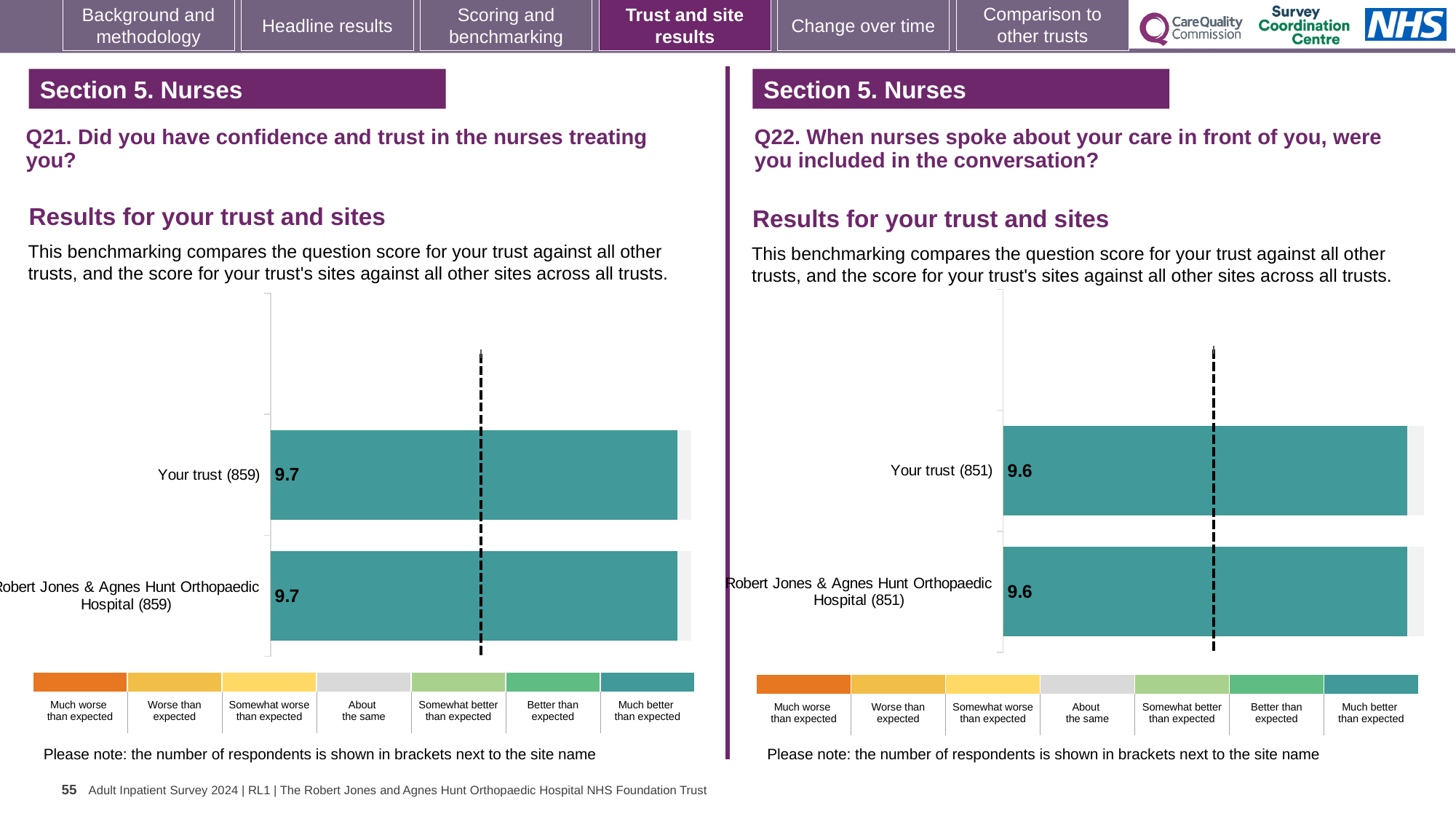
In the Q21 chart on the left, how many respondents are shown in brackets for Your trust? 859 In the Q22 chart on the right, what is the score for Robert Jones & Agnes Hunt Orthopaedic Hospital? 9.6 In the Q21 chart on the left, what is the score for Your trust? 9.7 In the Q21 chart on the left, what is the score for Robert Jones & Agnes Hunt Orthopaedic Hospital? 9.7 In the Q21 chart on the left, what is the difference between the score for Your trust and the score for Robert Jones & Agnes Hunt Orthopaedic Hospital? 0 In the Q22 chart on the right, what is the score for Your trust? 9.6 What kind of chart is used for the Q21 results on the left? Bar chart In the Q22 chart on the right, how many respondents are shown in brackets for Robert Jones & Agnes Hunt Orthopaedic Hospital? 851 How many bars are plotted in the Q21 chart on the left? 2 How many bars are plotted in the Q22 chart on the right? 2 In the Q22 chart on the right, what is the difference between the score for Your trust and the score for Robert Jones & Agnes Hunt Orthopaedic Hospital? 0 Is the score for Your trust in the Q22 chart on the right larger or smaller than the score for Your trust in the Q21 chart on the left? Smaller